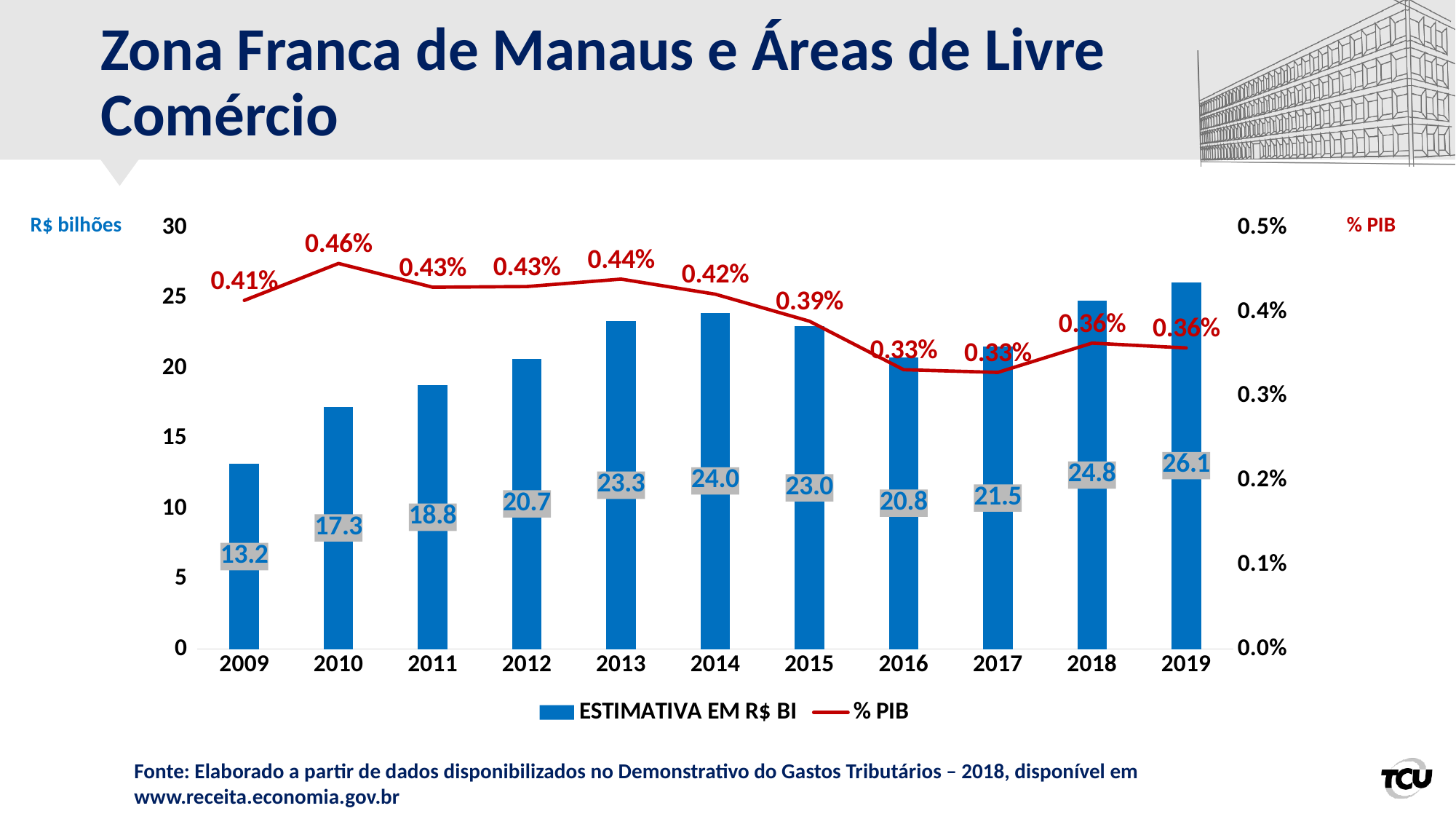
What kind of chart is shown on the slide? Combined bar and line chart What is the % PIB value for 2010? 0.46% What colour is the % PIB line? Red What is the value of ESTIMATIVA EM R$ BI for 2014? 24.0 Which year has the lowest ESTIMATIVA EM R$ BI value? 2009 How many years are shown on the x axis? 11 Which year has the highest % PIB value? 2010 What is the value of ESTIMATIVA EM R$ BI for 2016? 20.8 Which is larger, the ESTIMATIVA EM R$ BI value for 2013 or for 2015? 2013 How many series does the legend list? 2 What is the difference between the ESTIMATIVA EM R$ BI values for 2019 and 2009? 12.9 Which year has the highest ESTIMATIVA EM R$ BI value? 2019